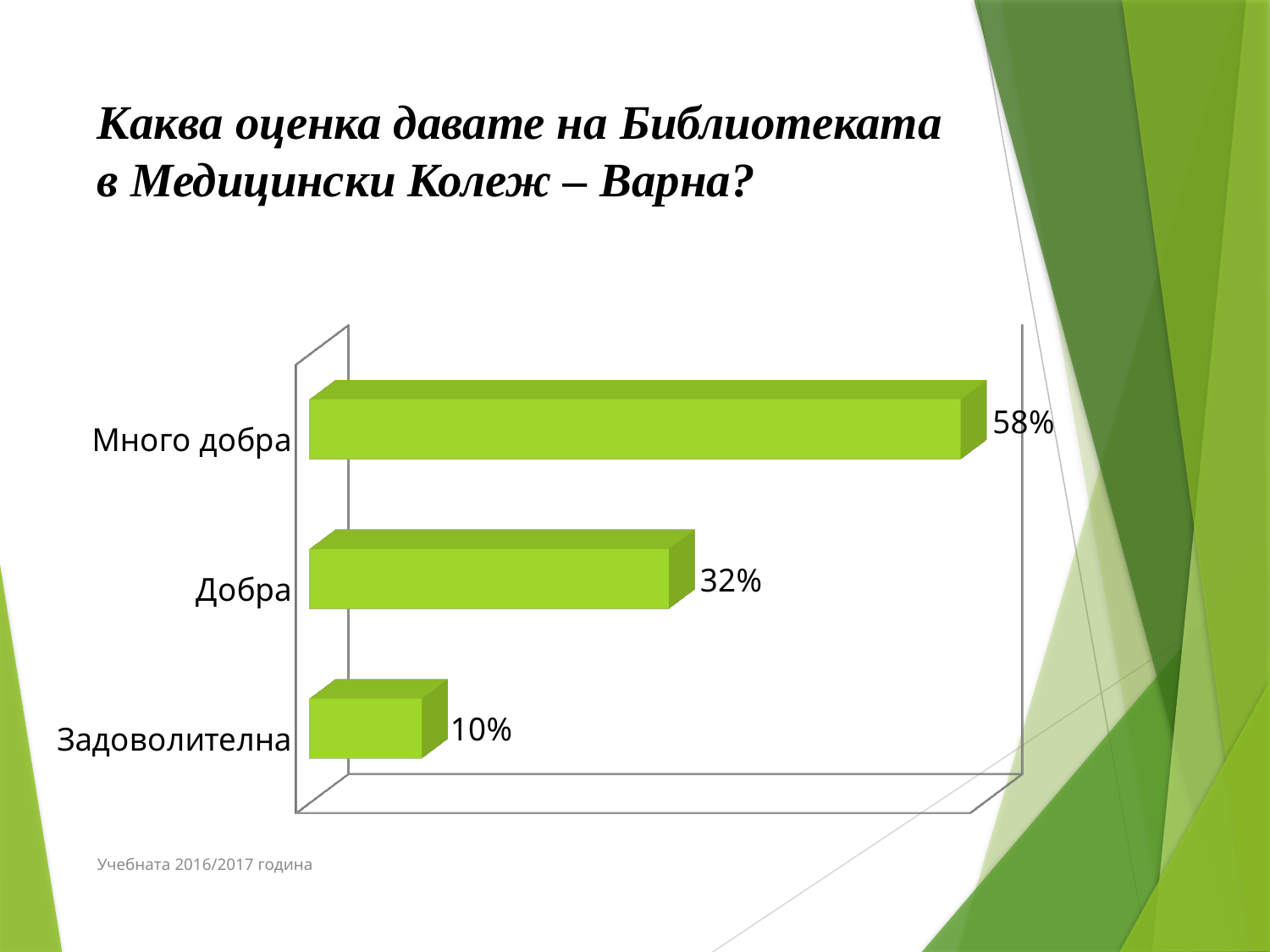
What colour are the bars in the chart? green Which category has the highest value? Много добра What is the total of the three values shown in the chart? 100% What is the difference between the values for Добра and Задоволителна? 22% What is the value for Добра? 32% Which category has the lowest value? Задоволителна What is the value for Много добра? 58% How many categories are shown in the chart? 3 What is the difference between the values for Много добра and Добра? 26% What kind of chart is shown on the slide? bar chart What is the value for Задоволителна? 10% Which is larger, the value for Добра or the value for Задоволителна? Добра